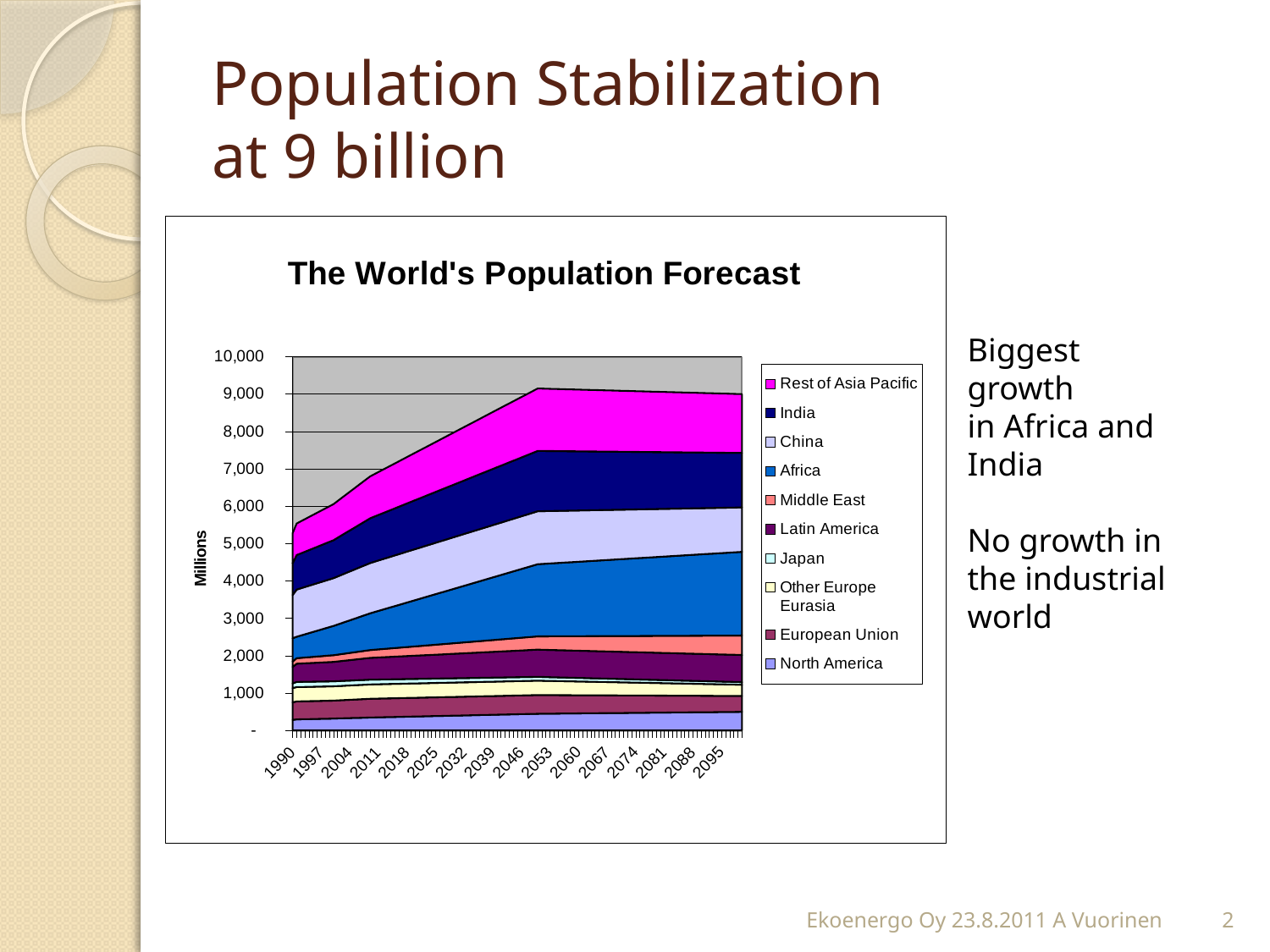
What is the first year shown on the x axis of the chart? 1990 What is the title of the chart on the slide? The World's Population Forecast Is the total stacked population value for 2053 greater or less than 8,000? greater How does the total world population change along the x axis from 1990 to 2095? Rises until about 2053, then levels off What kind of chart is 'The World's Population Forecast'? Stacked area chart What is the last year shown on the x axis of the chart? 2095 What is the label on the vertical axis of the chart? Millions Is the total stacked population value for 1990 greater or less than 5,000? greater Is the total stacked population value for 2095 greater or less than 8,000? greater How many series does the legend of 'The World's Population Forecast' list? 10 How many year labels are shown along the x axis of the chart? 16